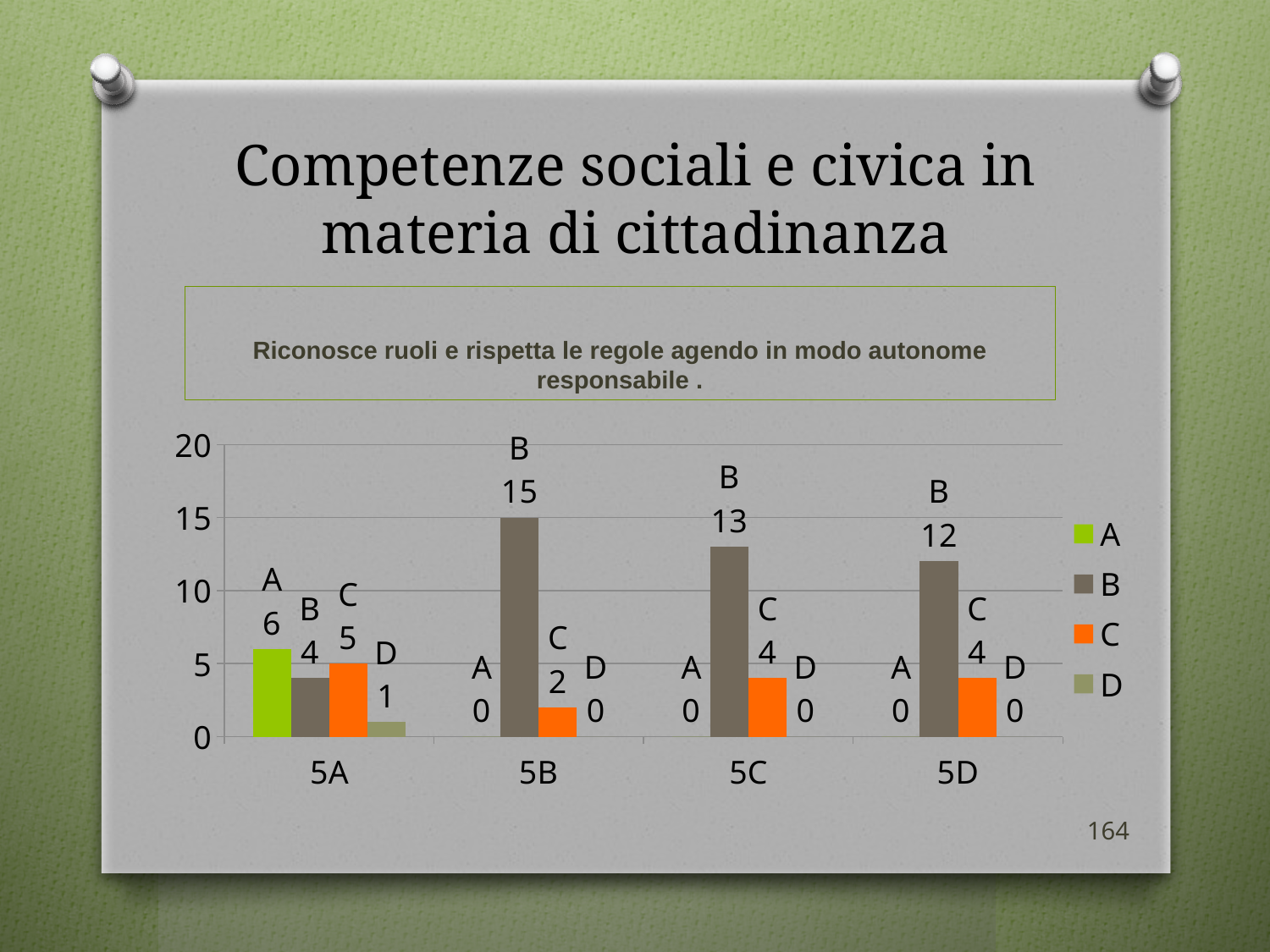
What is the value for C in class 5D? 4 What is the total of the four values for class 5C? 17 What is the difference between the B values for 5B and 5D? 3 What is the value for A in class 5A? 6 What is the value for B in class 5B? 15 How many series does the legend list? 4 Which class has the highest value for B? 5B Which is larger, the C value for 5A or the C value for 5B? 5A What kind of chart is shown on the slide? bar chart Which class has the lowest value for B? 5A What is the value for D in class 5A? 1 How many classes are shown on the x axis? 4